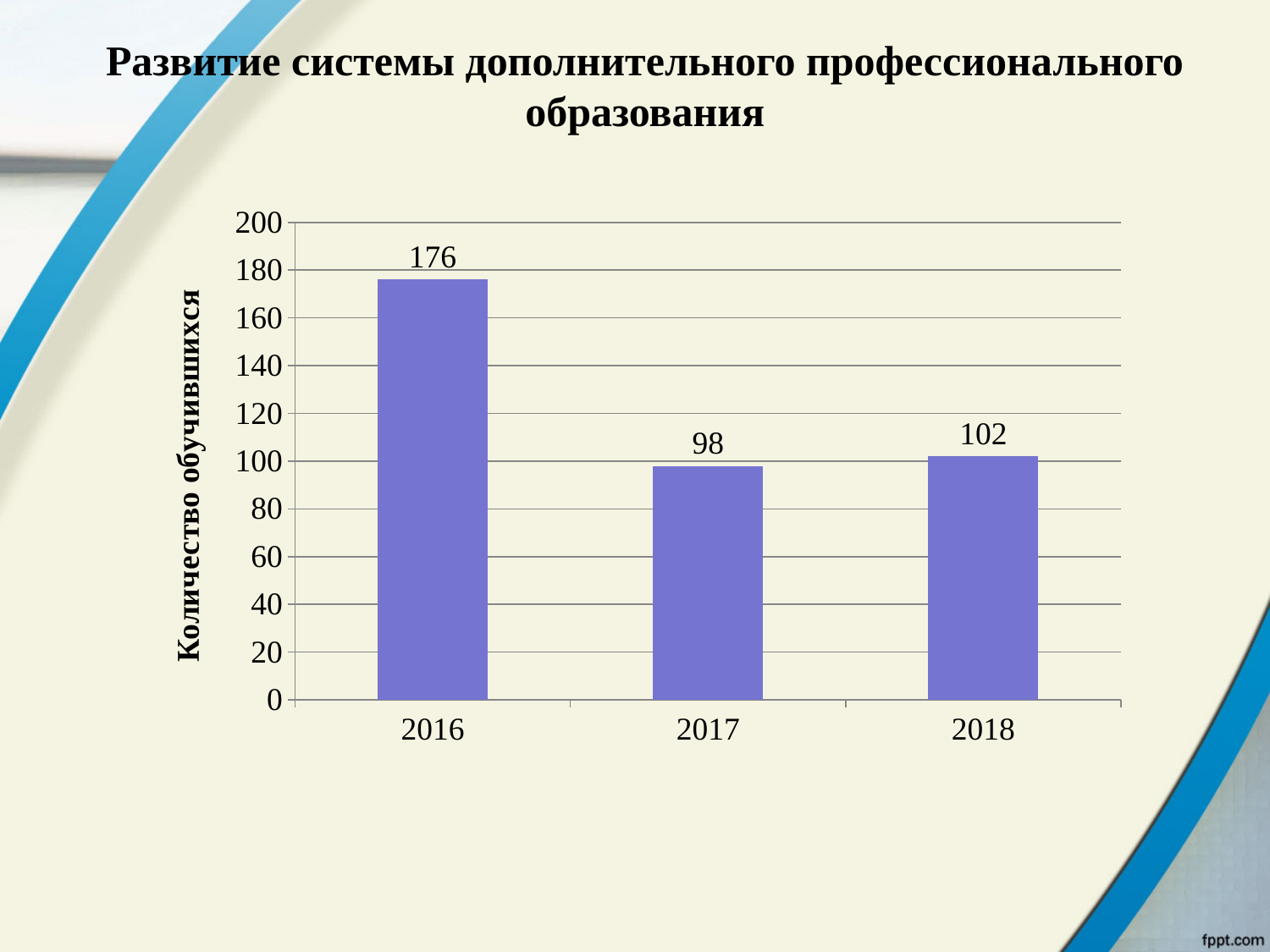
How many years are shown on the x axis? 3 What is the value for 2016? 176 Which is larger, the value for 2016 or the value for 2018? 2016 Which year has the lowest value? 2017 What is the value for 2017? 98 Which year has the highest value? 2016 What is the value for 2018? 102 Is the value for 2017 greater or less than 100? less What is the difference between the values for 2016 and 2017? 78 What is the difference between the values for 2018 and 2017? 4 What kind of chart is shown on the slide? bar chart What is the label of the vertical axis? Количество обучившихся